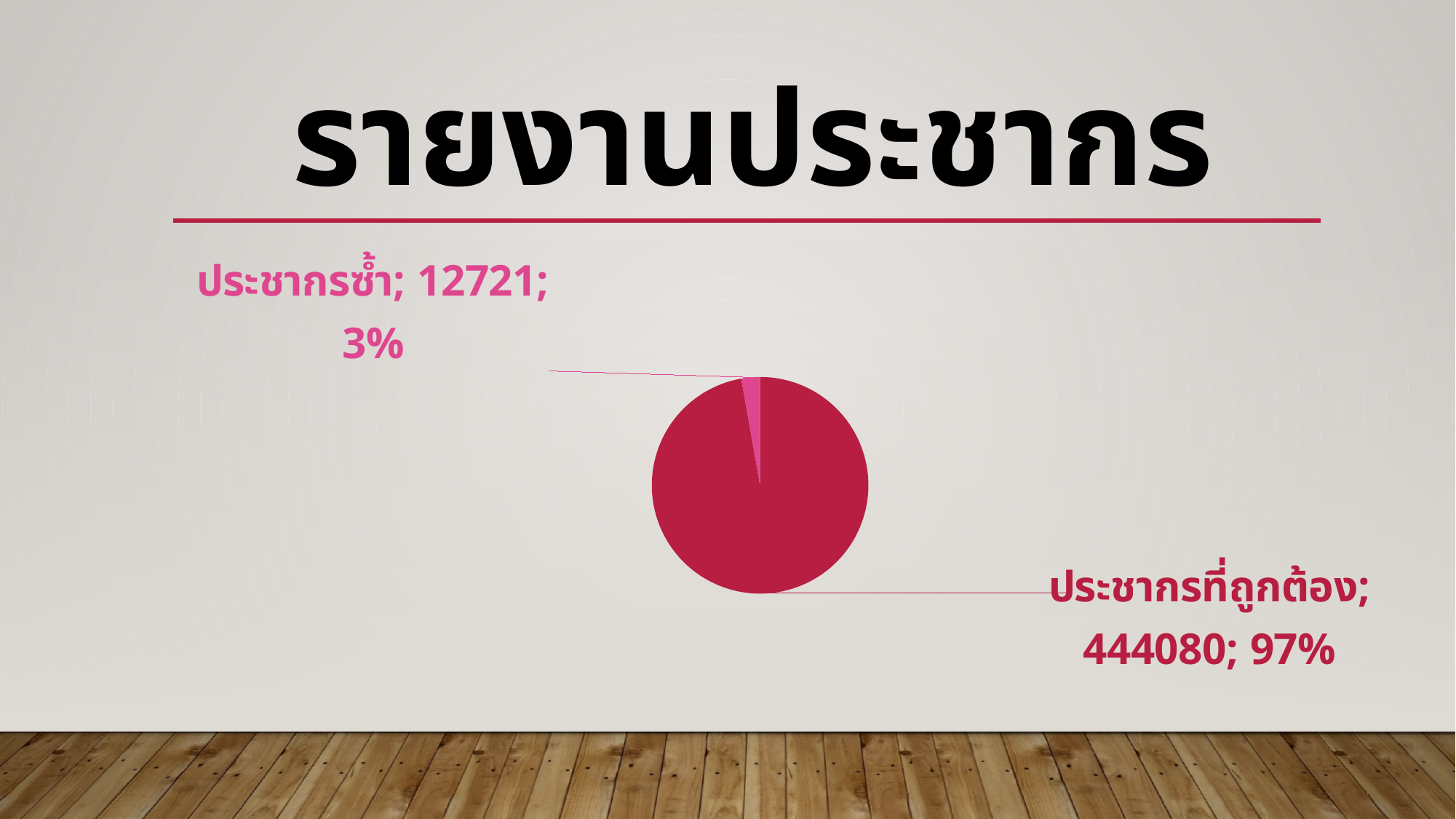
What is the value for ประชากรที่ถูกต้อง? 444080 What share of the pie does ประชากรซ้ำ represent? 3% Which slice is the largest? ประชากรที่ถูกต้อง What is the title of the slide? รายงานประชากร What is the difference between the values for ประชากรที่ถูกต้อง and ประชากรซ้ำ? 431359 What share of the pie does ประชากรที่ถูกต้อง represent? 97% What is the total of the two slices in the pie chart? 456801 Which is larger, ประชากรซ้ำ or ประชากรที่ถูกต้อง? ประชากรที่ถูกต้อง What is the value for ประชากรซ้ำ? 12721 Which slice is the smallest? ประชากรซ้ำ How many slices does the pie chart have? 2 What kind of chart is shown on the slide? pie chart